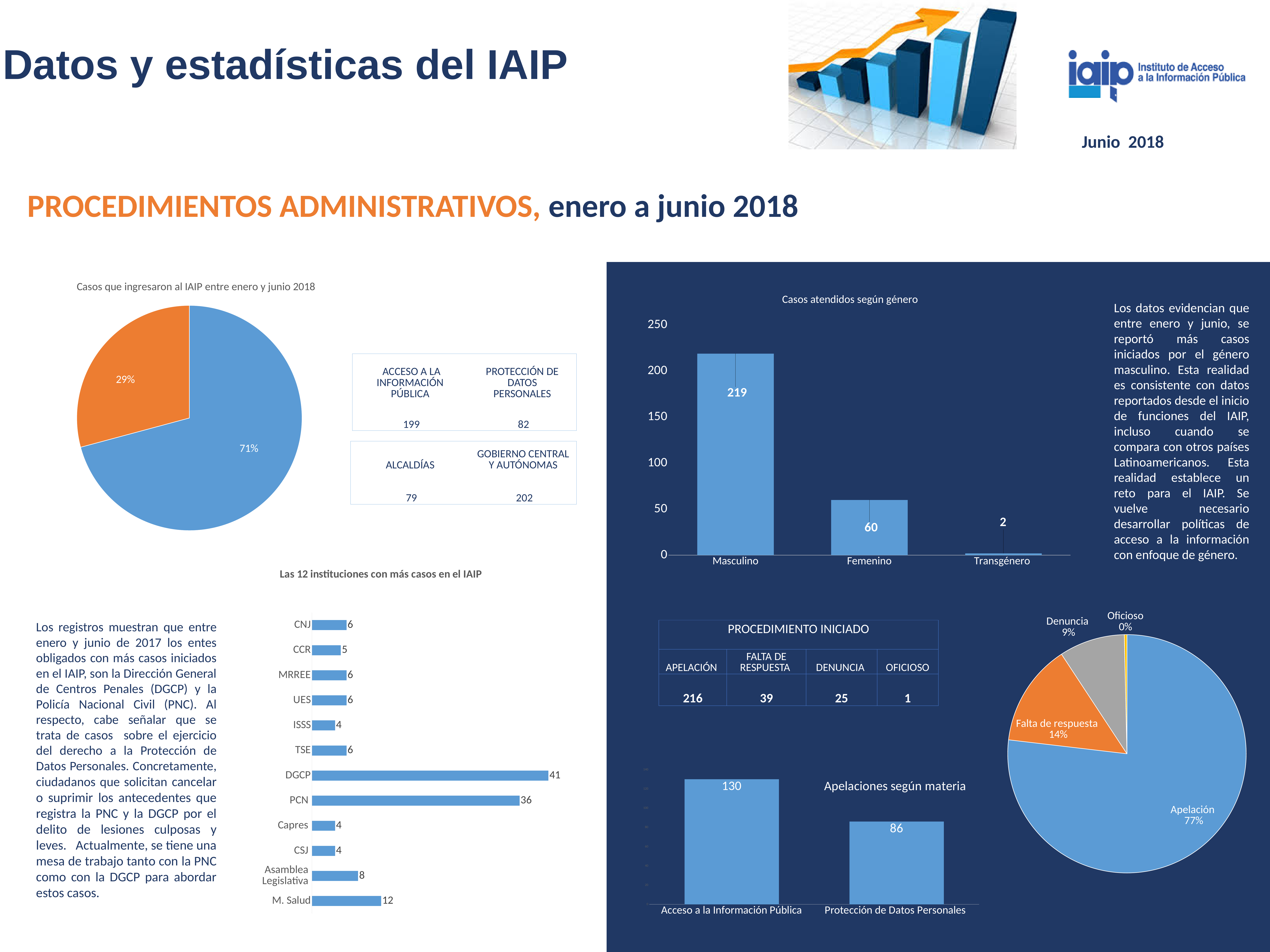
In the pie chart on the lower right of the slide, what share does Apelación have? 77% In the pie chart on the lower right of the slide, what share does Falta de respuesta have? 14% What type of chart is 'Las 12 instituciones con más casos en el IAIP'? Bar chart In the chart 'Las 12 instituciones con más casos en el IAIP', which institution has the highest value? DGCP In the chart 'Casos atendidos según género', which category has the lowest value? Transgénero In the chart 'Casos atendidos según género', what is the difference between Masculino and Femenino? 159 In the chart 'Las 12 instituciones con más casos en el IAIP', what is the value for PCN? 36 In the chart 'Las 12 instituciones con más casos en el IAIP', what is the value for M. Salud? 12 In the chart 'Casos atendidos según género', how many categories are shown on the x axis? 3 In the chart 'Las 12 instituciones con más casos en el IAIP', which is larger, Asamblea Legislativa or CCR? Asamblea Legislativa In the chart 'Casos atendidos según género', what is the value for Masculino? 219 In the chart 'Apelaciones según materia', what is the value for Protección de Datos Personales? 86